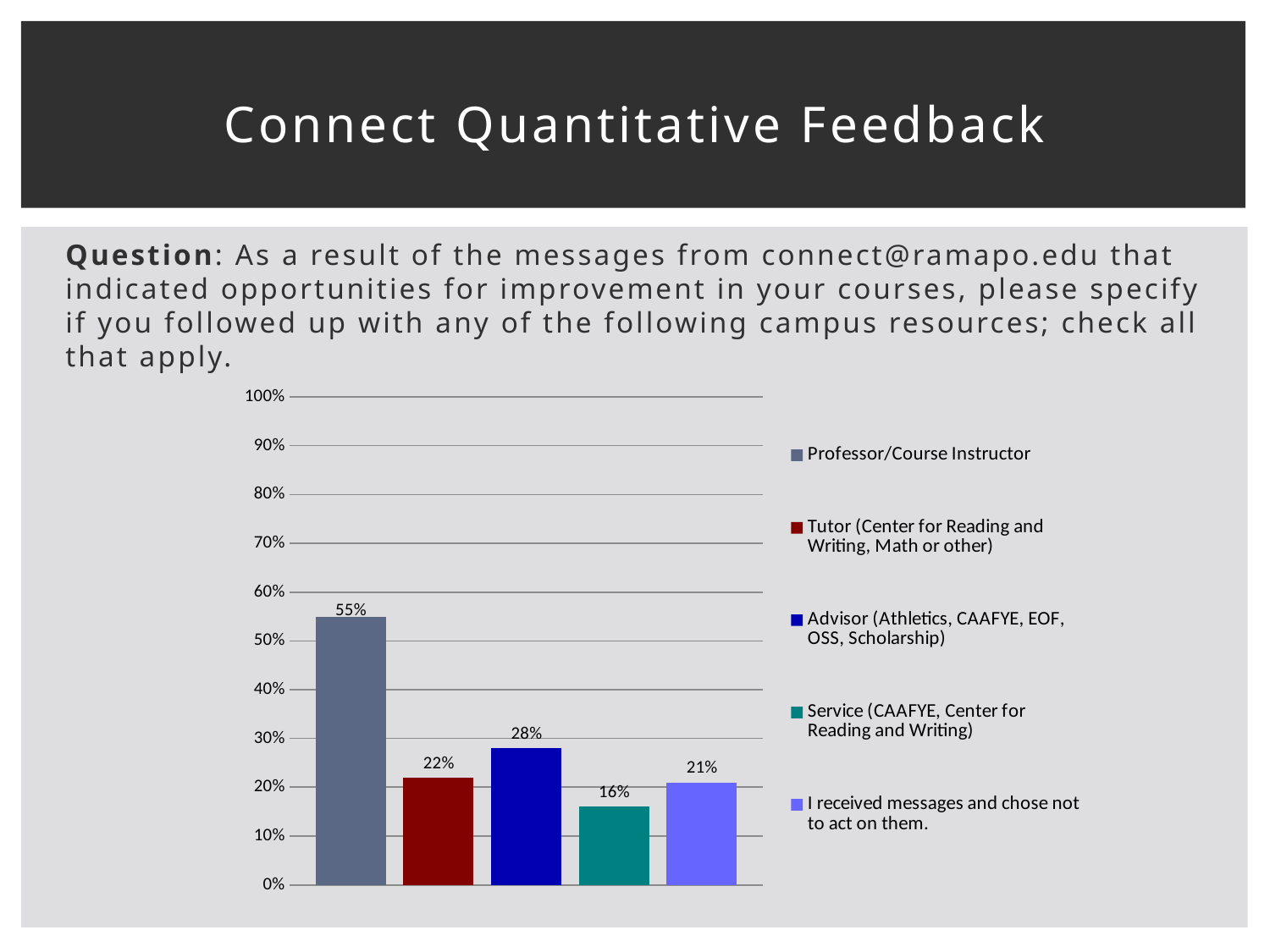
Which category has the highest value? Professor/Course Instructor Is the value for Professor/Course Instructor greater or less than 50%? greater What is the value for Advisor (Athletics, CAAFYE, EOF, OSS, Scholarship)? 28% What is the difference between the Tutor value and the Service value? 6% Which is larger, the value for Advisor or the value for Tutor? Advisor What percentage of respondents received messages and chose not to act on them? 21% What percentage of respondents followed up with a Professor/Course Instructor? 55% Which category has the lowest value? Service (CAAFYE, Center for Reading and Writing) How many categories does the legend list? 5 What kind of chart is shown on the slide? Bar chart What is the value for Tutor (Center for Reading and Writing, Math or other)? 22% What is the difference between the Professor/Course Instructor value and the Advisor value? 27%